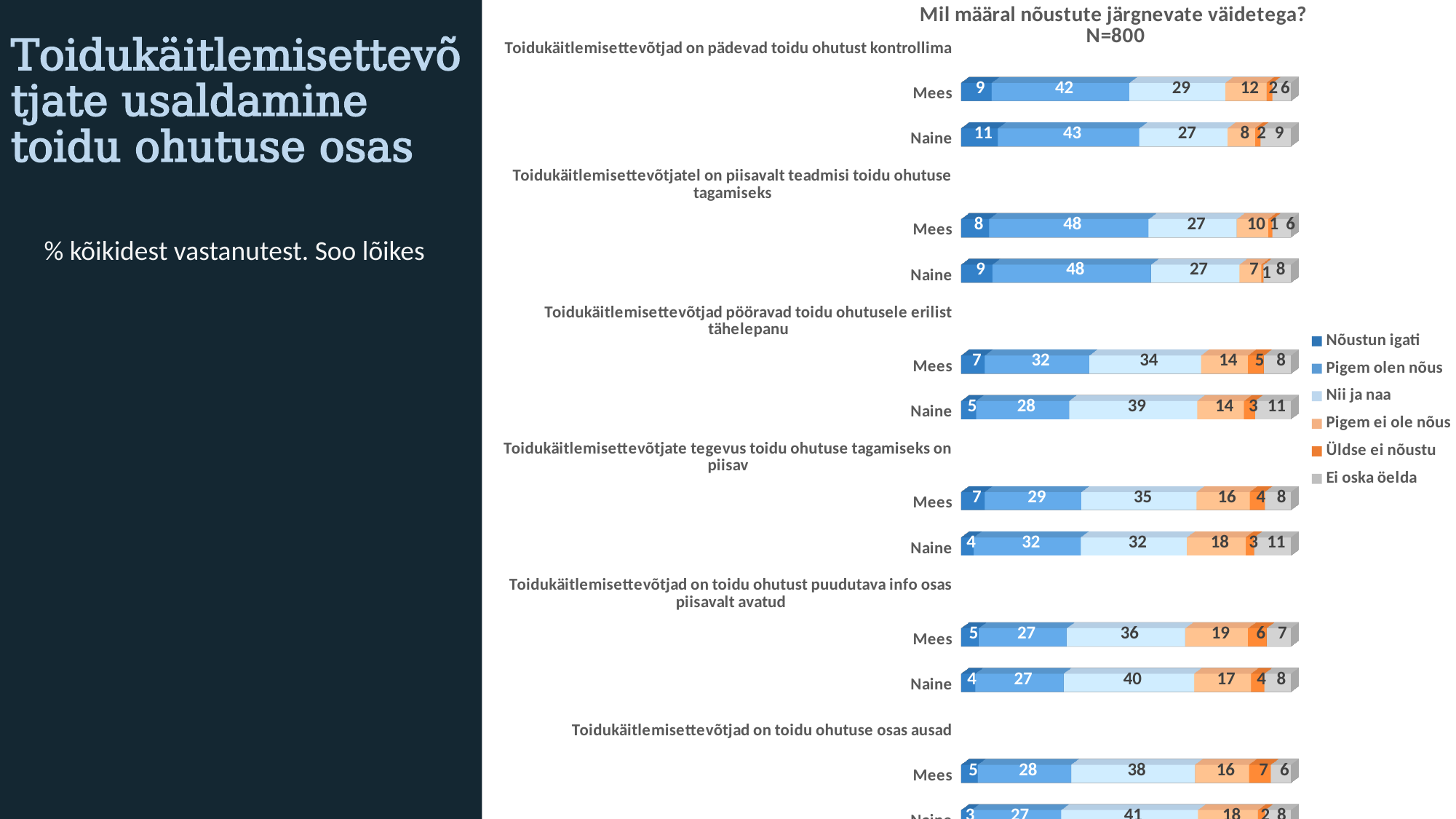
How many series does the legend list? 6 What is the total of the 'Nõustun igati' and 'Pigem olen nõus' values for Naine on the statement 'Toidukäitlemisettevõtjatel on piisavalt teadmisi toidu ohutuse tagamiseks'? 57 What is the 'Pigem olen nõus' value for Mees on the statement 'Toidukäitlemisettevõtjad on pädevad toidu ohutust kontrollima'? 42 On the statement 'Toidukäitlemisettevõtjatel on piisavalt teadmisi toidu ohutuse tagamiseks', what is the difference between the 'Pigem ei ole nõus' values for Mees and Naine? 3 What is the 'Pigem ei ole nõus' value for Mees on the statement 'Toidukäitlemisettevõtjad on toidu ohutust puudutava info osas piisavalt avatud'? 19 On the statement 'Toidukäitlemisettevõtjad on pädevad toidu ohutust kontrollima', which has the larger 'Nõustun igati' value, Mees or Naine? Naine Which legend entry is shown in grey? Ei oska öelda Which response category has the highest value for Mees on the statement 'Toidukäitlemisettevõtjad on toidu ohutuse osas ausad'? Nii ja naa What is the 'Nii ja naa' value for Naine on the statement 'Toidukäitlemisettevõtjad pööravad toidu ohutusele erilist tähelepanu'? 39 What sample size (N) is stated in the chart title? N=800 What kind of chart is shown on the slide? stacked bar chart What is the 'Ei oska öelda' value for Naine on the statement 'Toidukäitlemisettevõtjate tegevus toidu ohutuse tagamiseks on piisav'? 11